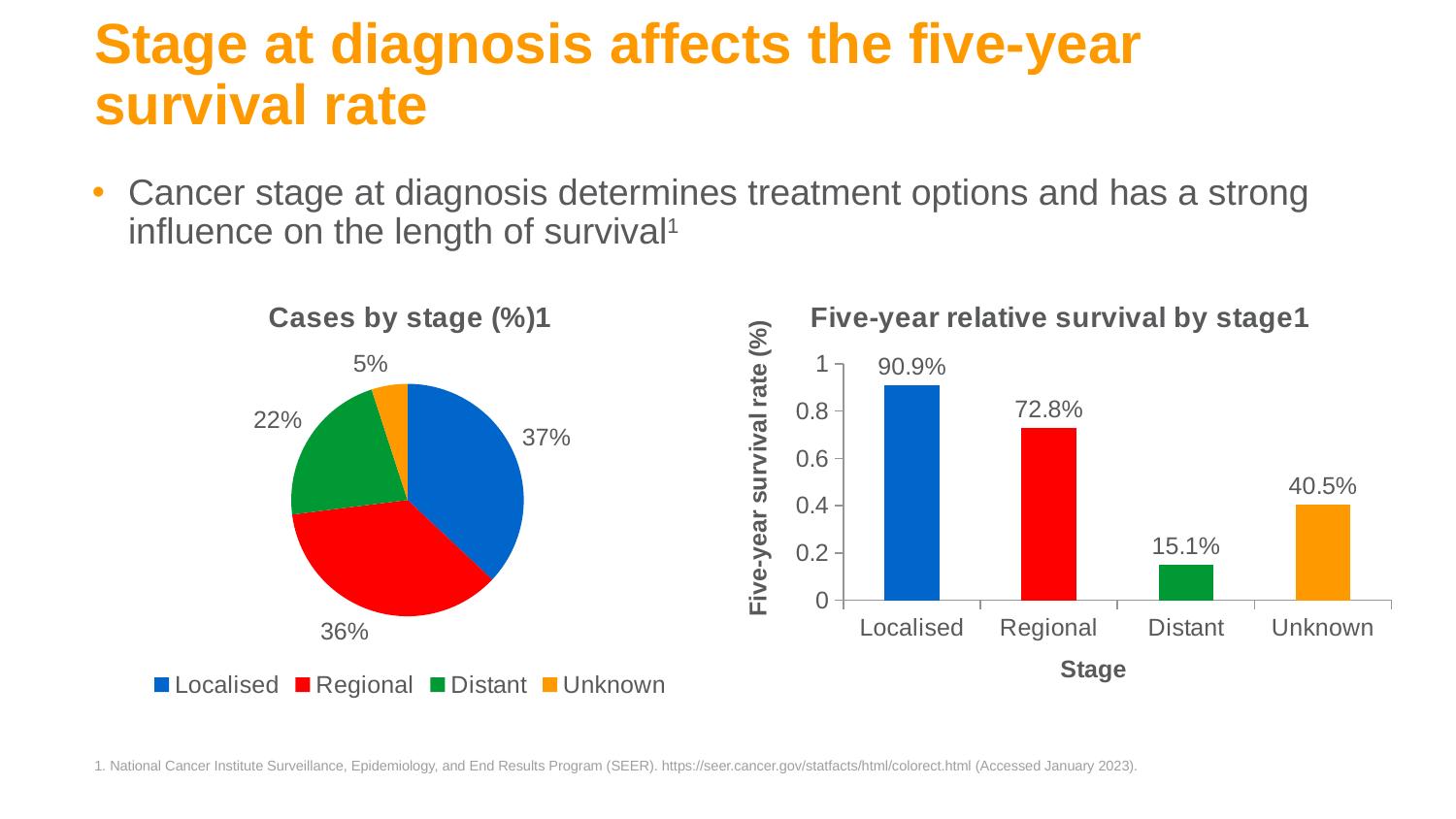
What kind of chart is 'Cases by stage (%)'? Pie chart In the 'Five-year relative survival by stage' chart, what is the five-year survival rate for Distant? 15.1% How many stages are shown in the 'Five-year relative survival by stage' chart? 4 In the 'Cases by stage (%)' chart, which stage has the smallest share of cases? Unknown In the 'Cases by stage (%)' chart, what share of cases is Unknown? 5% In the 'Five-year relative survival by stage' chart, what is the five-year survival rate for Regional? 72.8% In the 'Five-year relative survival by stage' chart, which stage has the lowest five-year survival rate? Distant In the 'Cases by stage (%)' chart, what is the difference between the Regional and Distant shares? 14% In the 'Five-year relative survival by stage' chart, what is the difference between the Localised and Unknown survival rates? 50.4% In the 'Cases by stage (%)' chart, what share of cases is Localised? 37% In the 'Cases by stage (%)' chart, which stage has the largest share of cases? Localised In the 'Five-year relative survival by stage' chart, which has a higher survival rate, Regional or Unknown? Regional